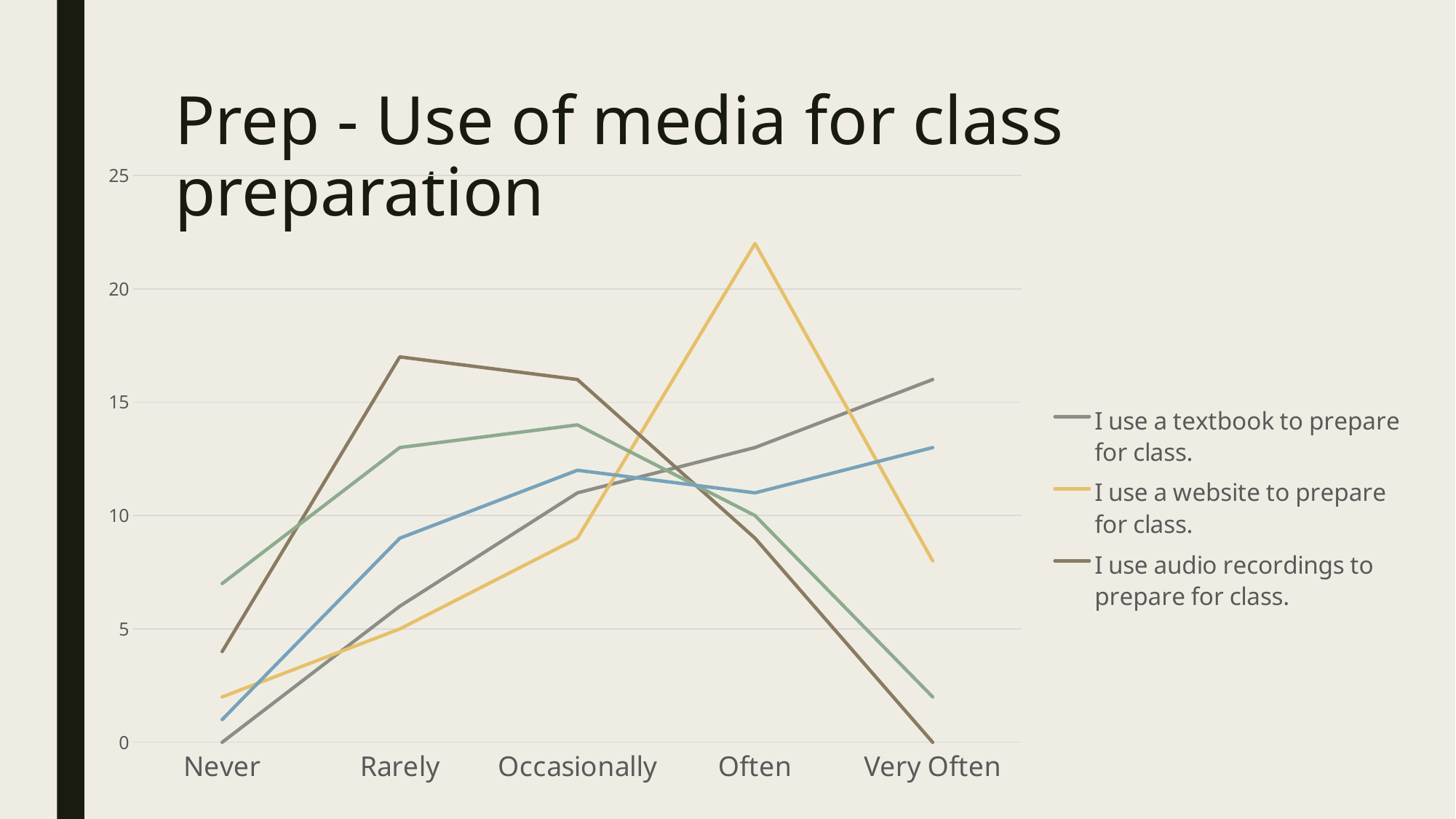
At which category does 'I use a website to prepare for class.' reach its highest value? Often At Often, which is larger: 'I use a website to prepare for class.' or 'I use a textbook to prepare for class.'? I use a website to prepare for class. What is the value for 'I use a textbook to prepare for class.' at Never? 0 Is the value for 'I use audio recordings to prepare for class.' at Never greater or less than 5? less What is the title of the chart on the slide? Prep - Use of media for class preparation At which category is 'I use a textbook to prepare for class.' lowest? Never Is the value for 'I use a website to prepare for class.' at Often greater or less than 20? greater How many series does the legend list? 3 How many categories are shown along the x axis? 5 What is the value for 'I use audio recordings to prepare for class.' at Very Often? 0 What kind of chart is shown on the slide? line chart Does the line for 'I use a textbook to prepare for class.' rise or fall from Never to Very Often? rise